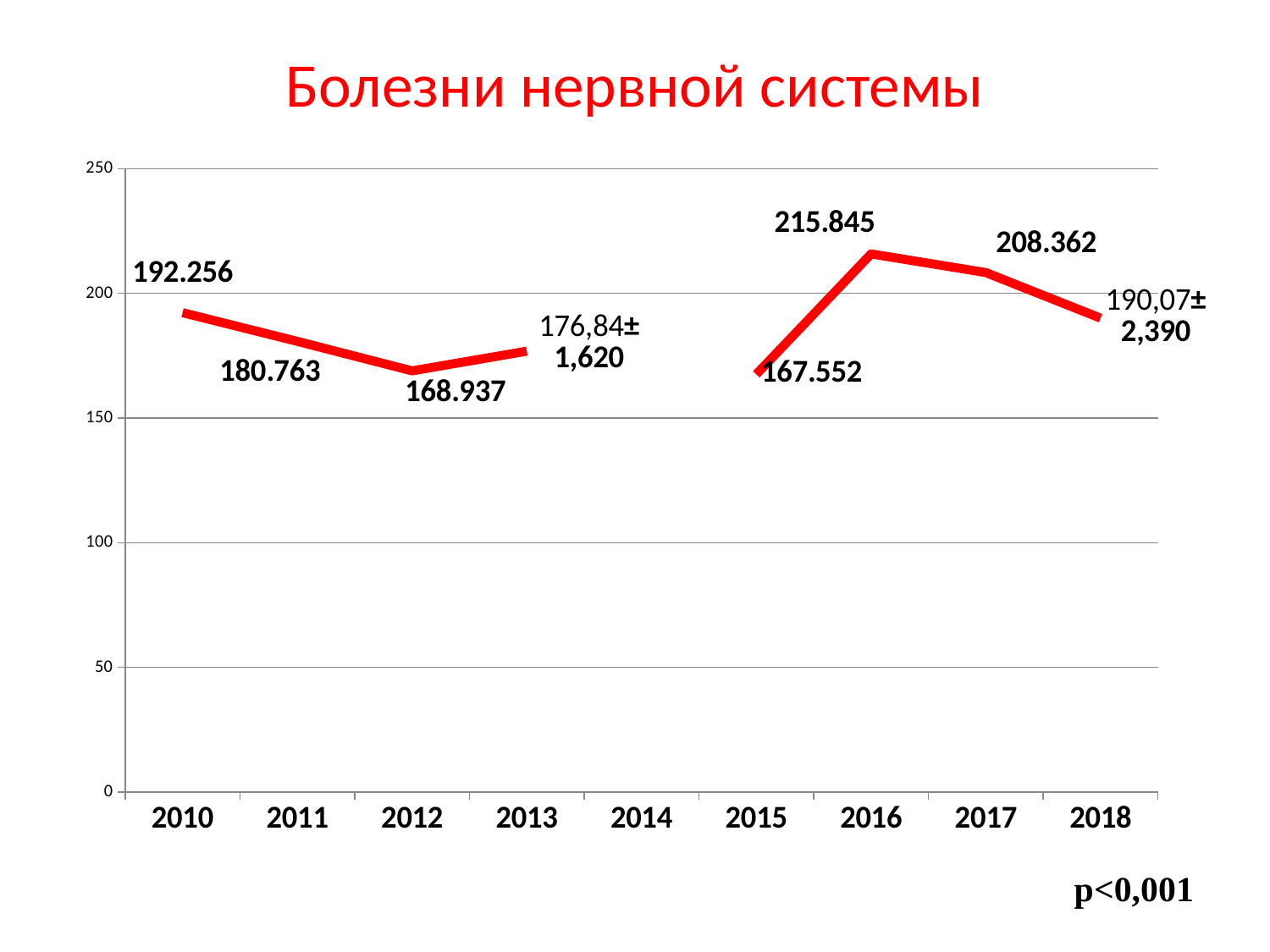
Which year has the highest value? 2016 What is the difference between the values for 2016 and 2017? 7.483 What is the value for 2017? 208.362 Which is larger, the value for 2011 or the value for 2012? 2011 What is the value for 2016? 215.845 What is the value for 2012? 168.937 What is the value for 2010? 192.256 How many year labels appear on the x axis? 9 Which year has the lowest value? 2015 What kind of chart is shown on the slide? line chart Is the value for 2016 greater or less than 200? greater Do the values rise or fall from 2016 to 2018? fall